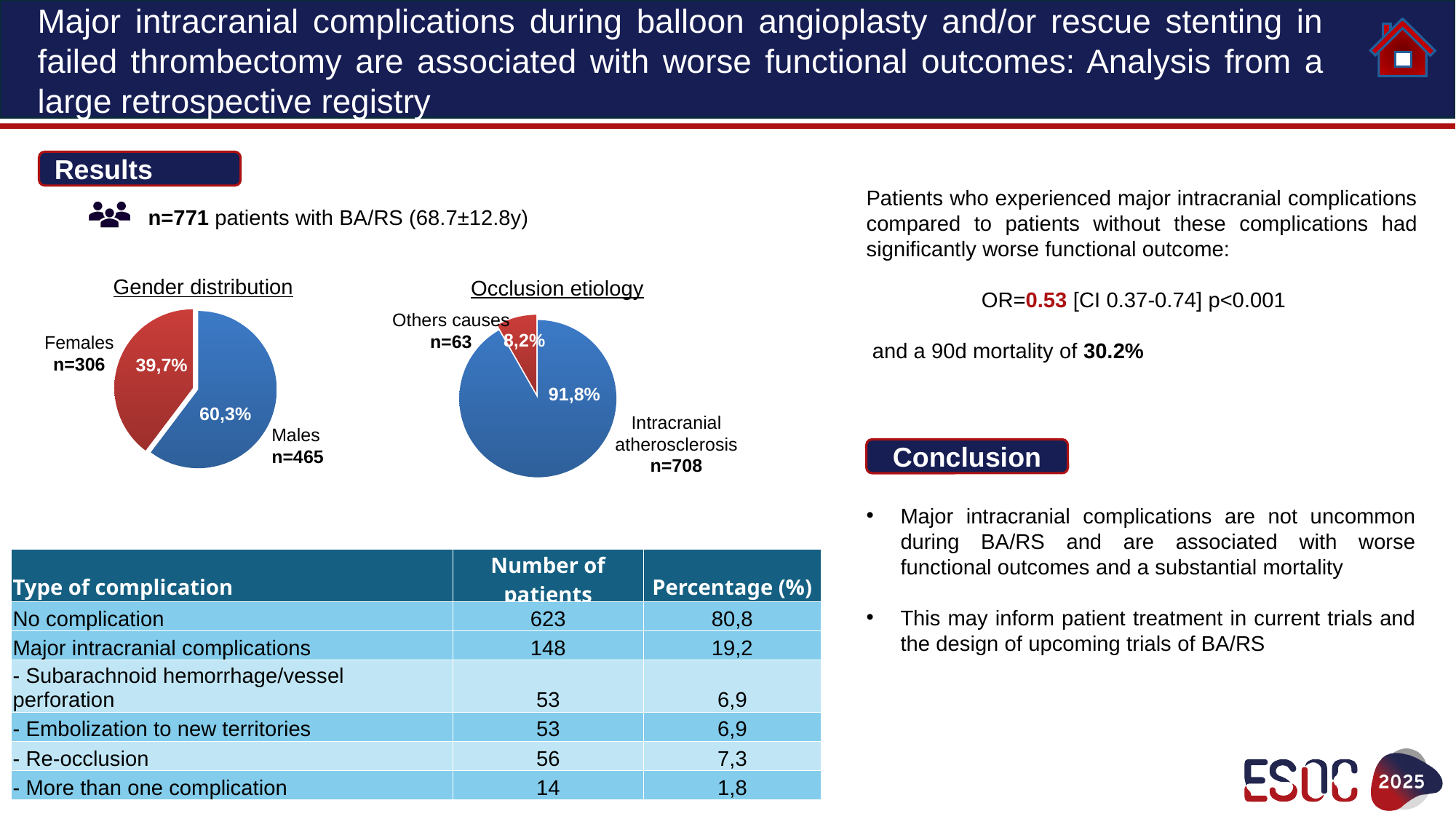
In the Occlusion etiology chart, what percentage of patients have intracranial atherosclerosis? 91,8% In the Occlusion etiology chart, which category has the smallest share? Others causes In the Gender distribution chart, which group has the larger share? Males In the Occlusion etiology chart, how many patients have intracranial atherosclerosis? n=708 In the Gender distribution chart, what is the difference in percentage points between males and females? 20,6 In the Gender distribution chart, how many female patients are there? n=306 What kind of chart is the Gender distribution chart? Pie chart In the Occlusion etiology chart, what percentage of patients have other causes? 8,2% In the Gender distribution chart, what percentage of patients are males? 60,3% In the Occlusion etiology chart, what colour is the Others causes slice? Red In the Gender distribution chart, what percentage of patients are females? 39,7% How many slices does the Occlusion etiology pie chart have? 2